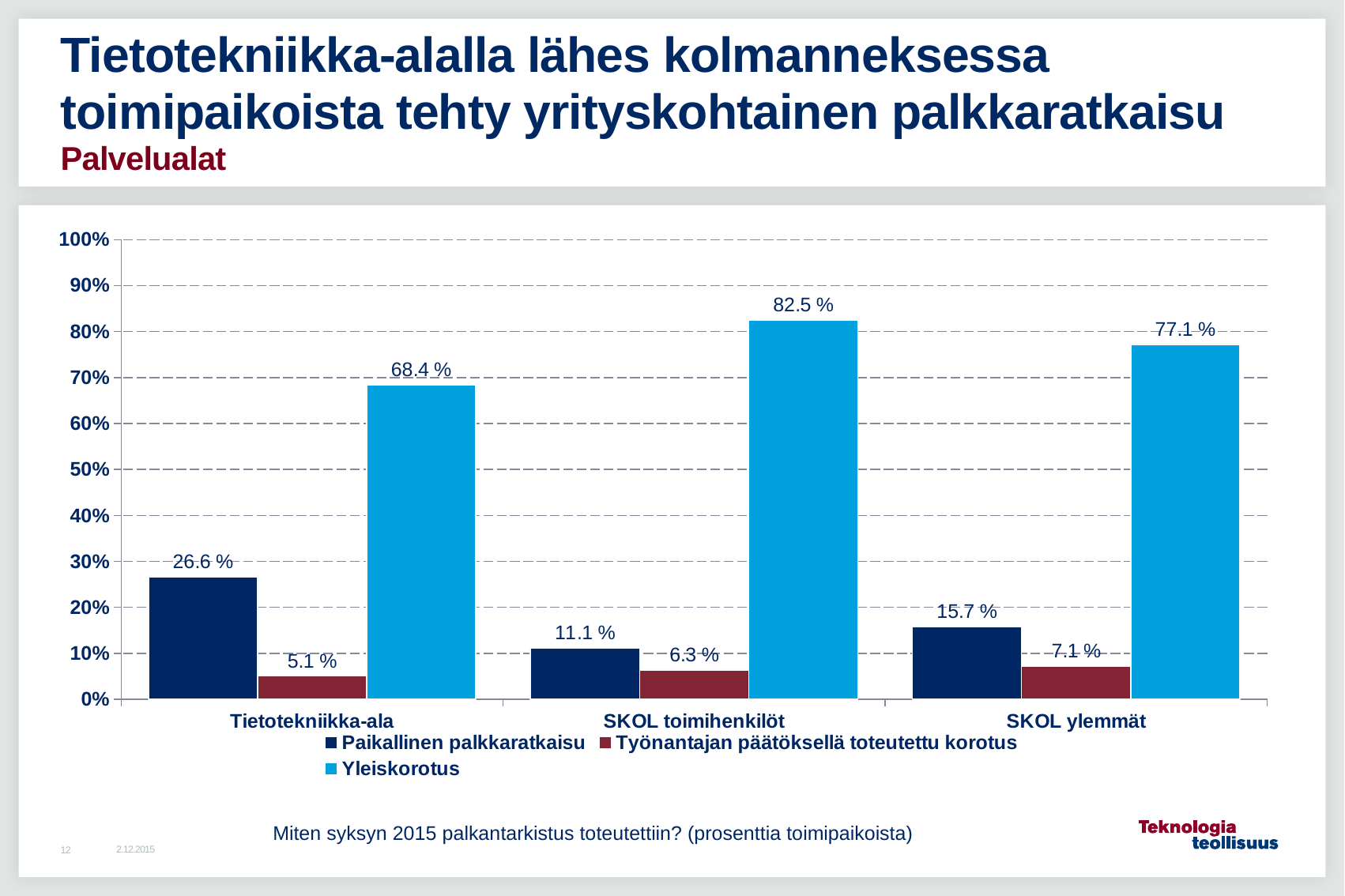
How many categories are shown on the x axis? 3 What is the value of Työnantajan päätöksellä toteutettu korotus for SKOL ylemmät? 7.1 % Which series is shown in light blue in the legend? Yleiskorotus Which is larger: Paikallinen palkkaratkaisu for Tietotekniikka-ala or for SKOL ylemmät? Tietotekniikka-ala What is the value of Paikallinen palkkaratkaisu for Tietotekniikka-ala? 26.6 % How many series does the legend list? 3 What is the difference between the Yleiskorotus values for SKOL toimihenkilöt and Tietotekniikka-ala? 14.1 % What kind of chart is shown on the slide? bar chart Is the Yleiskorotus value for SKOL ylemmät greater or less than 70%? greater What is the value of Yleiskorotus for SKOL toimihenkilöt? 82.5 % Which category has the lowest value for Paikallinen palkkaratkaisu? SKOL toimihenkilöt Which category has the highest value for Yleiskorotus? SKOL toimihenkilöt